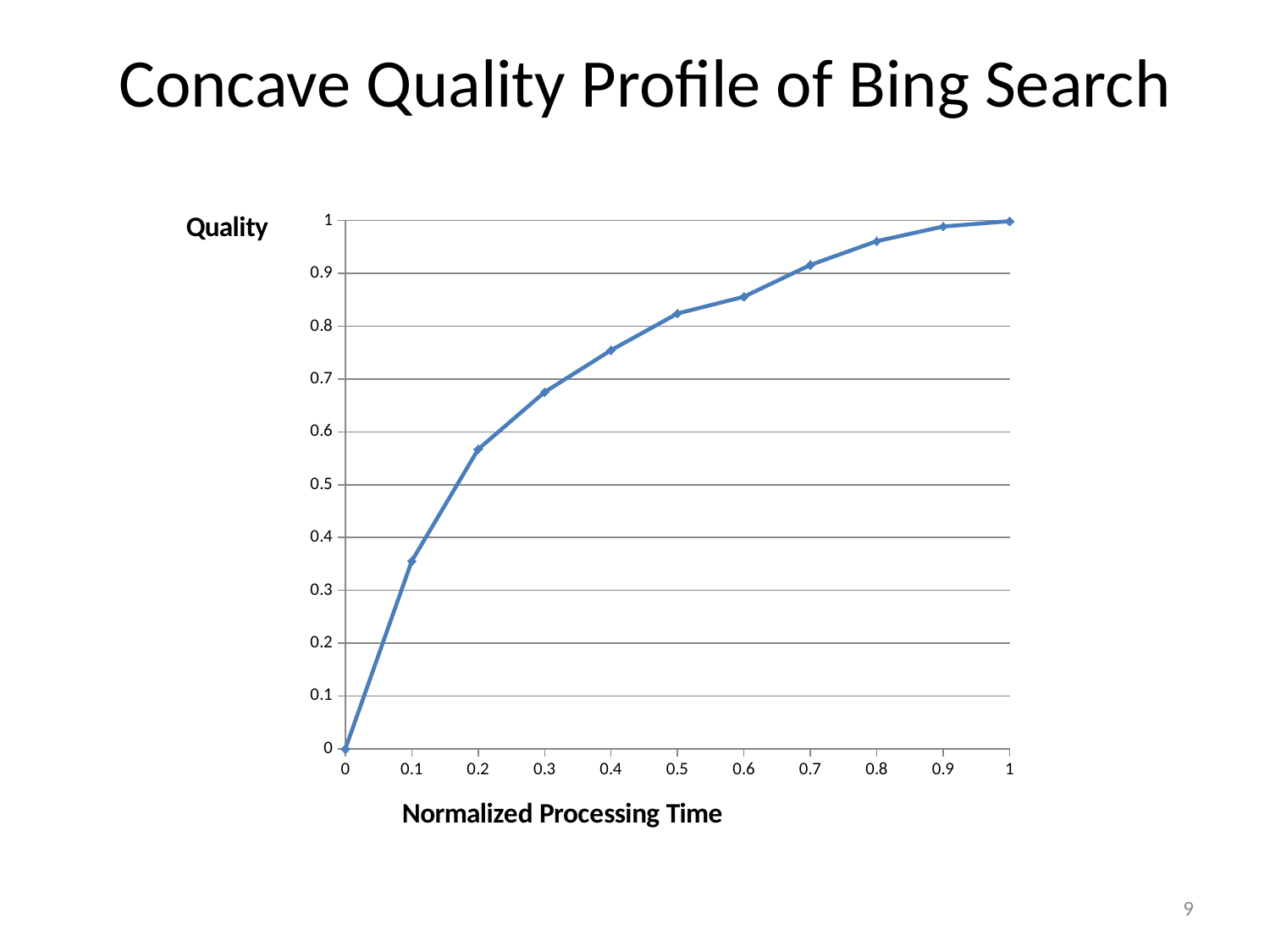
Which is larger, the Quality at Normalized Processing Time 0.3 or at 0.7? 0.7 At which Normalized Processing Time is Quality lowest? 0 Is the Quality value at Normalized Processing Time 0.5 greater or less than 0.8? greater What is the title of the chart on the slide? Concave Quality Profile of Bing Search Is the Quality value at Normalized Processing Time 0.1 greater or less than 0.4? less What kind of chart is shown on the slide? line chart Is the Quality value at Normalized Processing Time 0.2 greater or less than 0.5? greater How many data points are plotted on the line? 11 Does Quality rise or fall as Normalized Processing Time increases? rise At which Normalized Processing Time is Quality highest? 1 What is the Quality value at Normalized Processing Time 0? 0